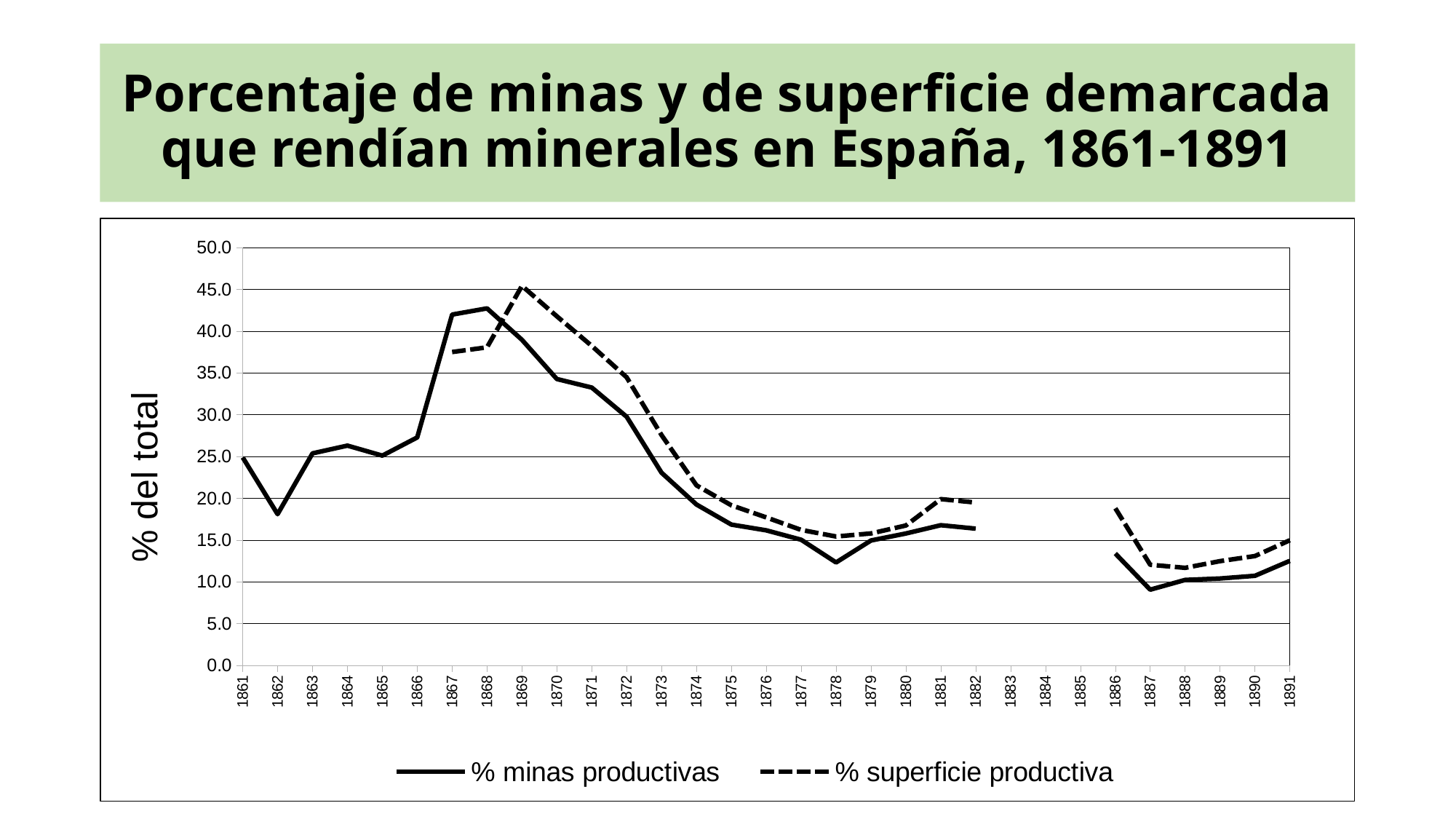
In which year does the % minas productivas series reach its lowest value? 1887 Is the value for % minas productivas in 1878 greater or less than 10.0? greater Is the value for % superficie productiva in 1869 greater or less than 40.0? greater In 1867, which series is higher: % minas productivas or % superficie productiva? % minas productivas In 1869, which series is higher: % minas productivas or % superficie productiva? % superficie productiva In which year does the % superficie productiva series reach its highest value? 1869 How many years are labelled along the x axis? 31 Does the % minas productivas series rise or fall between 1869 and 1878? fall How many series does the legend list? 2 Is the value for % minas productivas in 1862 greater or less than 20.0? less What kind of chart is shown on the slide? line chart What is the title of the y axis? % del total